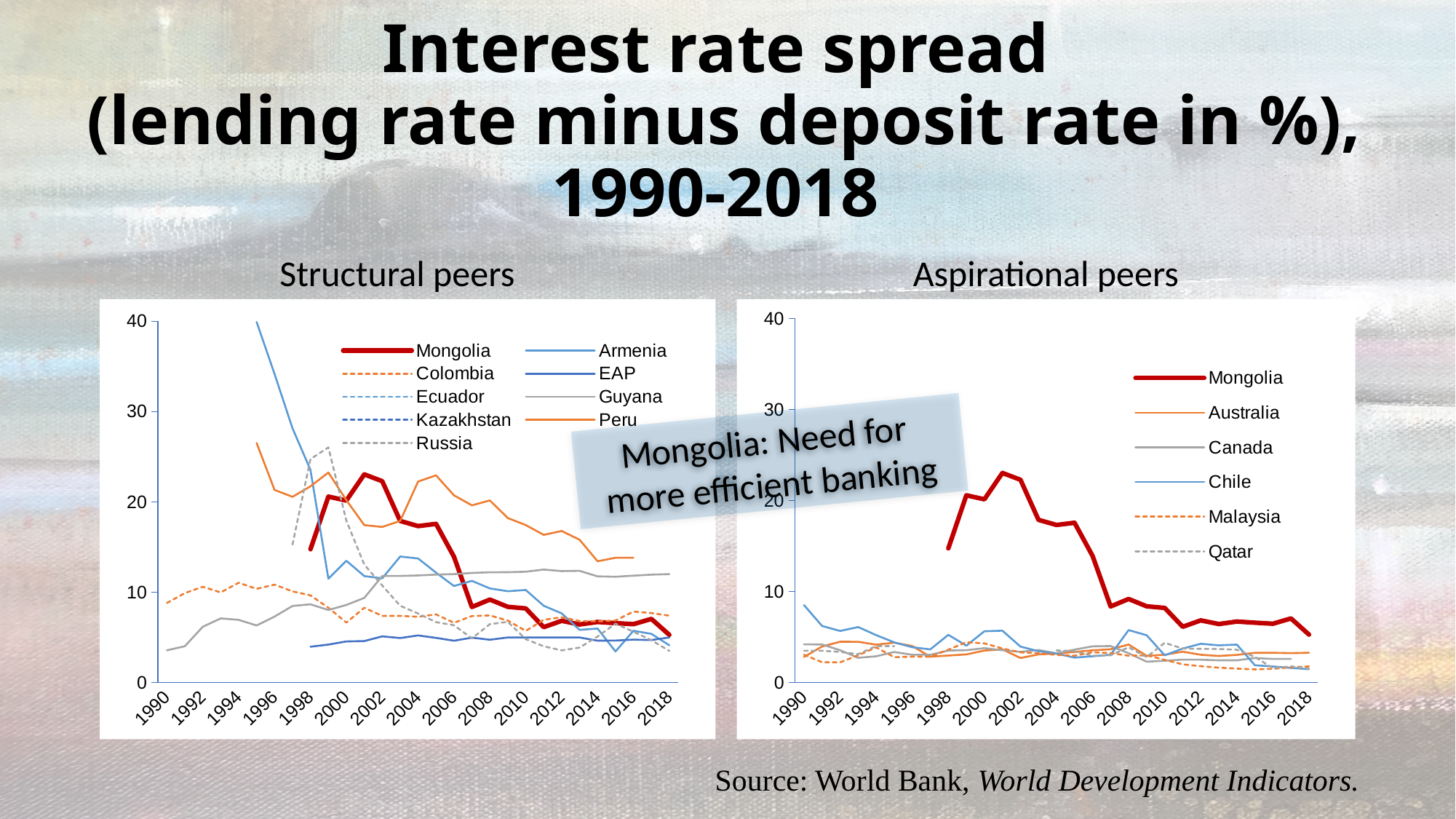
How many series does the legend of the "Aspirational peers" chart list? 6 How many series does the legend of the "Structural peers" chart list? 9 What does the text box overlaid between the two charts say? Mongolia: Need for more efficient banking In the "Structural peers" chart, does the Mongolia line generally rise or fall between 2002 and 2018? fall In the "Structural peers" chart, does the Peru line generally rise or fall between 1996 and 2018? fall In the "Aspirational peers" chart, is the value for Mongolia in 2018 greater or less than 10? less In the "Structural peers" chart, is the value for Armenia in 1996 greater or less than 30? greater In the "Aspirational peers" chart, is the value for Mongolia in 2002 greater or less than 20? greater What is the title of the slide containing the two charts? Interest rate spread (lending rate minus deposit rate in %), 1990-2018 What kind of chart is the "Structural peers" chart? line chart